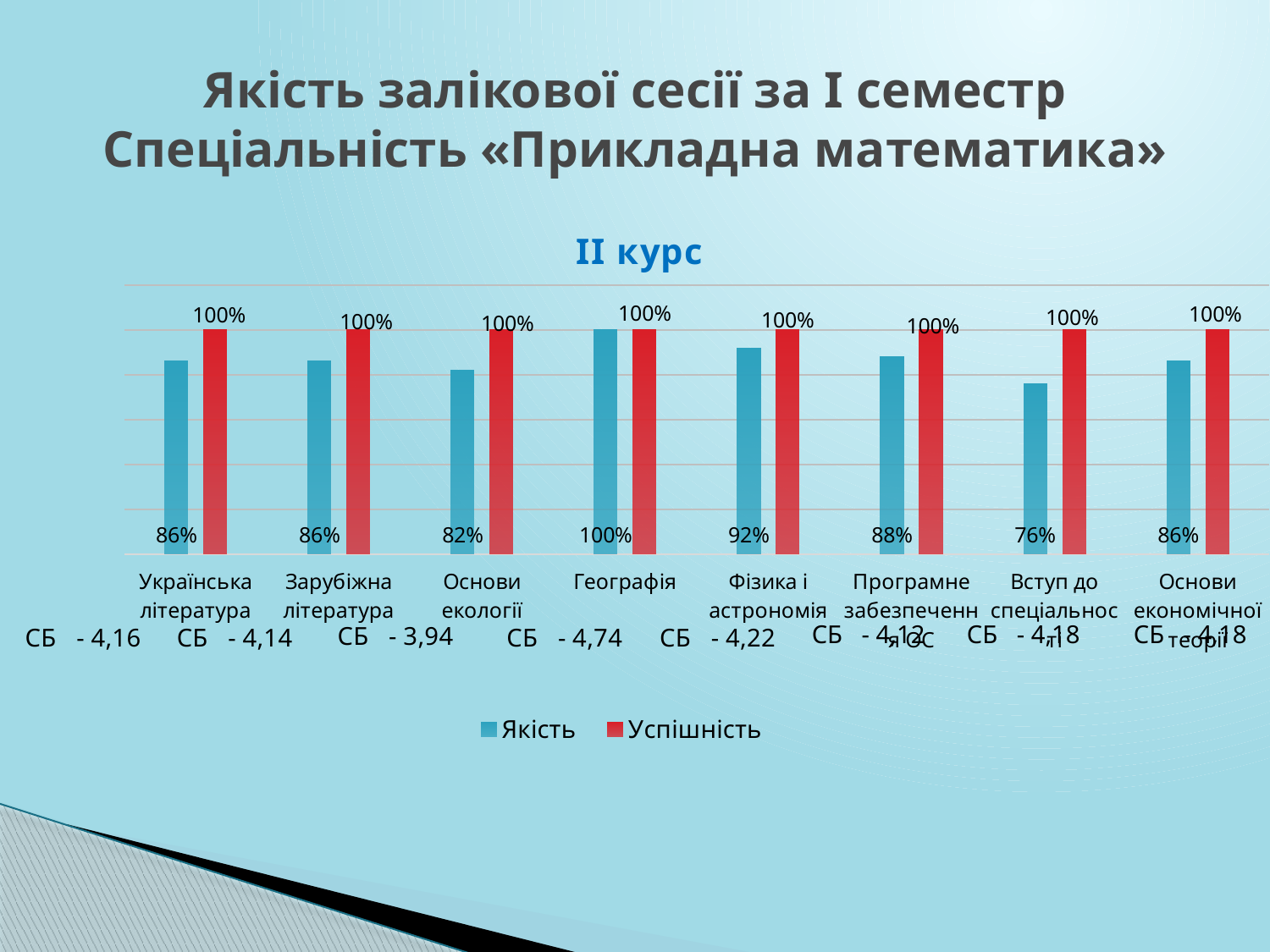
Which category has the lowest Якість value? Вступ до спеціальності What kind of chart is shown on the slide? Bar chart How many series does the legend list? 2 What is the title of the chart? ІІ курс How many categories are shown on the x axis? 8 Which category has the highest Якість value? Географія What is the Якість value for Географія? 100% Which is larger, the Якість value for Українська література or for Фізика і астрономія? Фізика і астрономія What is the Якість value for Основи екології? 82% What is the Успішність value for Фізика і астрономія? 100% What is the difference between the Якість values for Фізика і астрономія and Основи екології? 10% What is the Якість value for Зарубіжна література? 86%